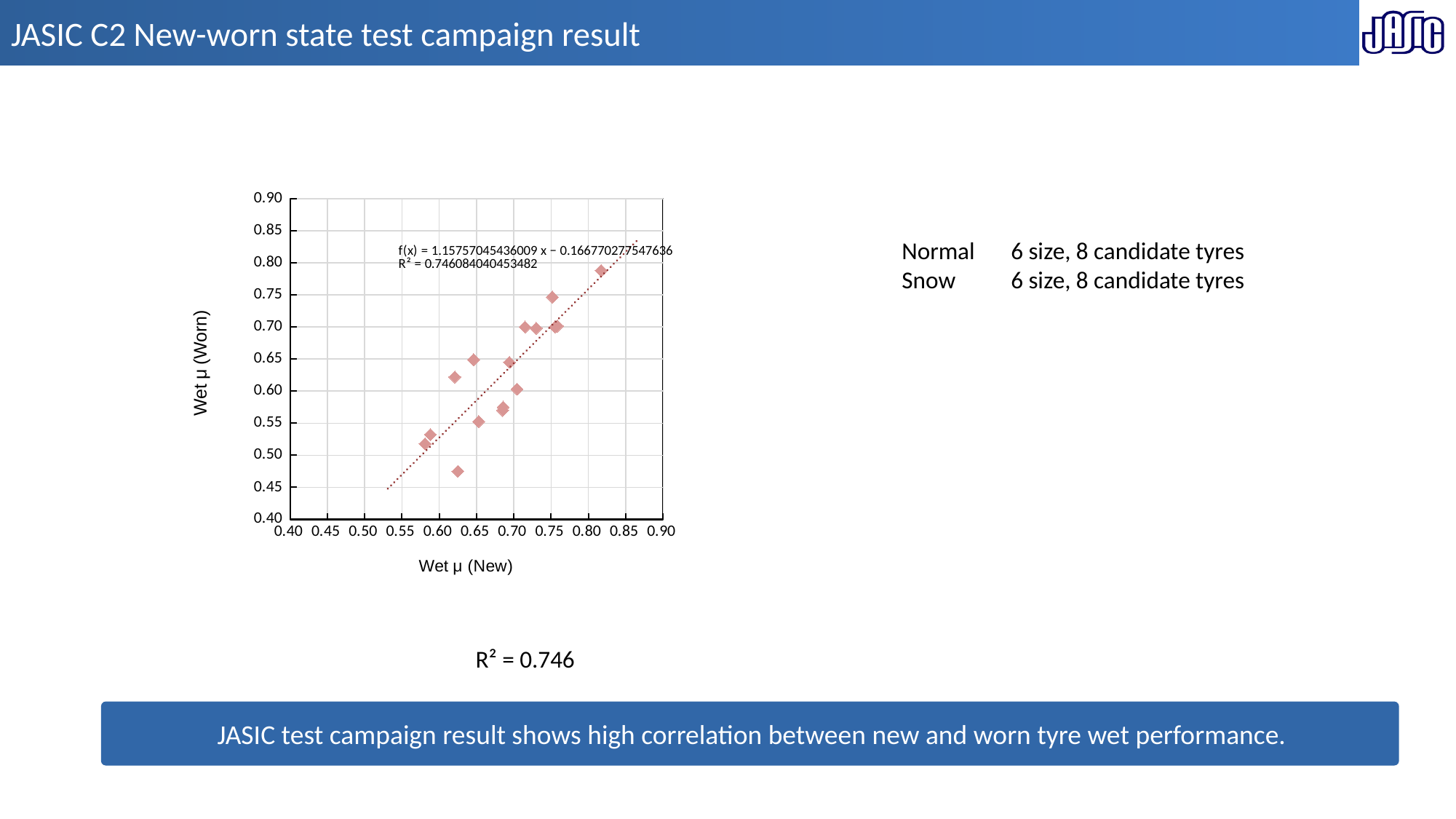
What kind of chart is shown on the slide? scatter chart Is the Wet μ (New) value of the rightmost point on the chart greater or less than 0.80? greater What is the minimum value shown on the x axis of the chart? 0.40 What is the intercept of the trendline equation printed on the chart? −0.166770277547636 Is the Wet μ (Worn) value of the lowest point on the chart greater or less than 0.50? less Do the Wet μ (Worn) values generally rise or fall as Wet μ (New) increases? rise What is the title of the y axis of the chart? Wet μ (Worn) What is the slope of the trendline equation printed on the chart? 1.15757045436009 Is the Wet μ (Worn) value of the highest point on the chart greater or less than 0.75? greater What R² value is printed below the chart? R² = 0.746 What is the title of the x axis of the chart? Wet μ (New) What is the maximum value shown on the y axis of the chart? 0.90